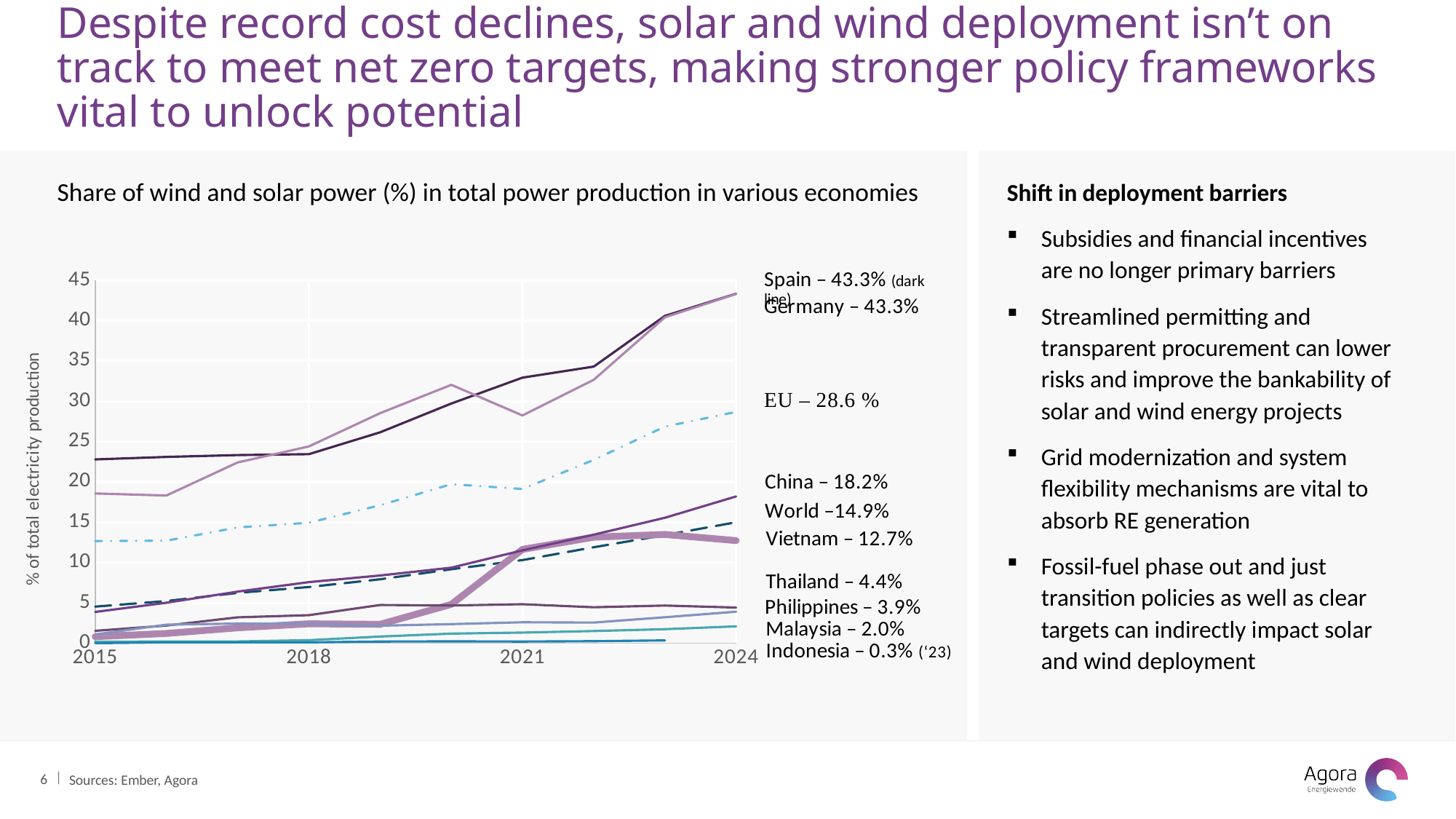
What is the difference between China's and the World's 2024 share of wind and solar power? 3.3 percentage points What is the share of wind and solar power for China in 2024? 18.2% Which economy has the lowest labelled share of wind and solar power? Indonesia What is the share of wind and solar power for Vietnam in 2024? 12.7% Which has a larger 2024 share of wind and solar power, Thailand or Philippines? Thailand What is the share of wind and solar power for the EU in 2024? 28.6 % Does Germany's share of wind and solar power rise or fall from 2015 to 2024? Rise What kind of chart is shown on the slide? Line chart Is the value for Vietnam in 2015 greater or less than 5? less What is the label of the y axis of the chart? % of total electricity production What is the World share of wind and solar power in 2024? 14.9% How many economies are labelled on the chart? 10